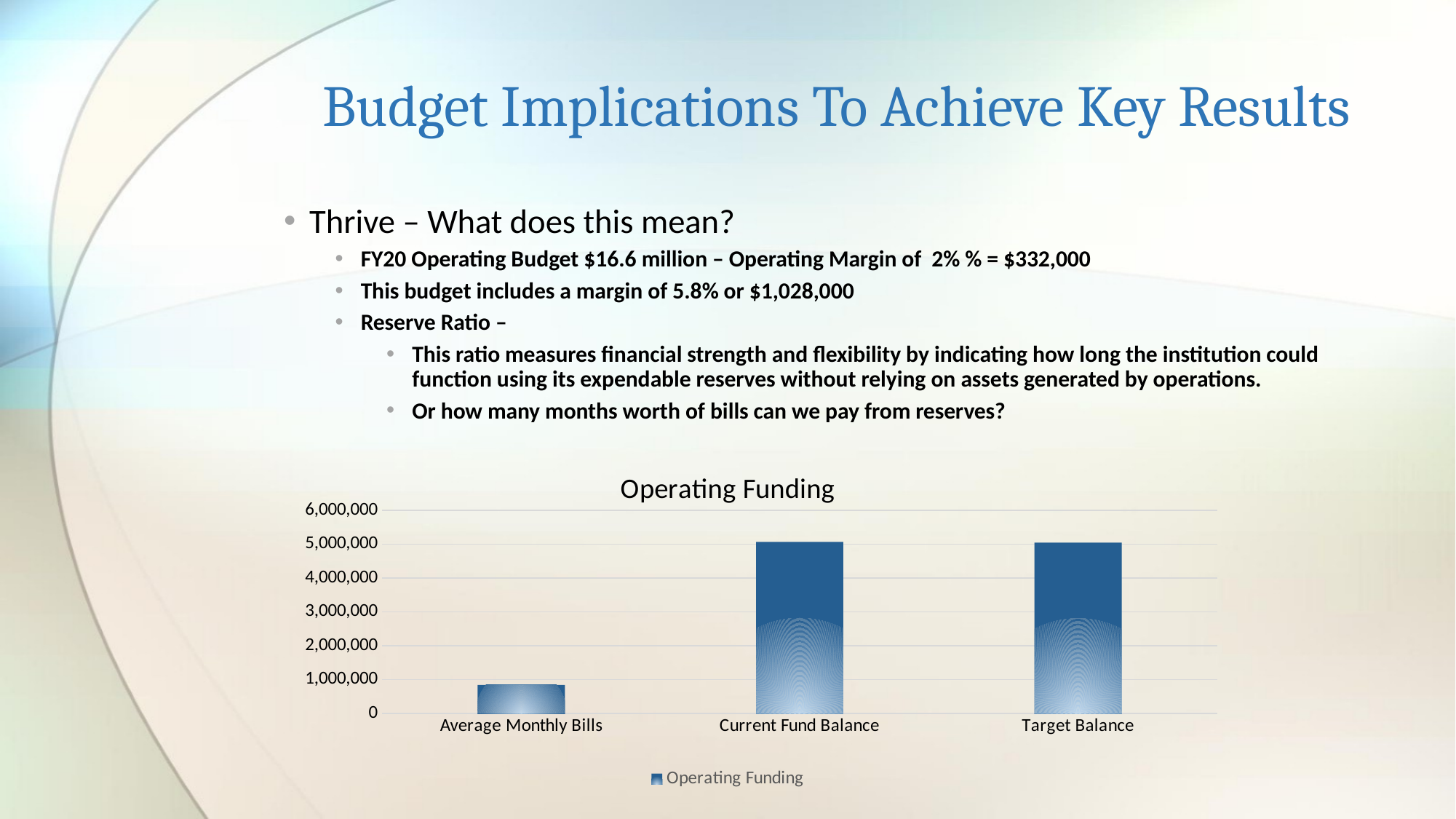
Is the value for Target Balance greater or less than 4,000,000? greater What is the name of the series shown in the legend of the Operating Funding chart? Operating Funding Which category has the lowest value in the Operating Funding chart? Average Monthly Bills How many series does the legend of the Operating Funding chart list? 1 Is the value for Current Fund Balance greater or less than 4,000,000? greater Is the value for Average Monthly Bills greater or less than 1,000,000? less Which is larger in the Operating Funding chart, Average Monthly Bills or Current Fund Balance? Current Fund Balance What is the title of the chart on the slide? Operating Funding How many categories are shown on the x axis of the Operating Funding chart? 3 What type of chart is shown on the slide? Bar chart Which is larger in the Operating Funding chart, Target Balance or Average Monthly Bills? Target Balance